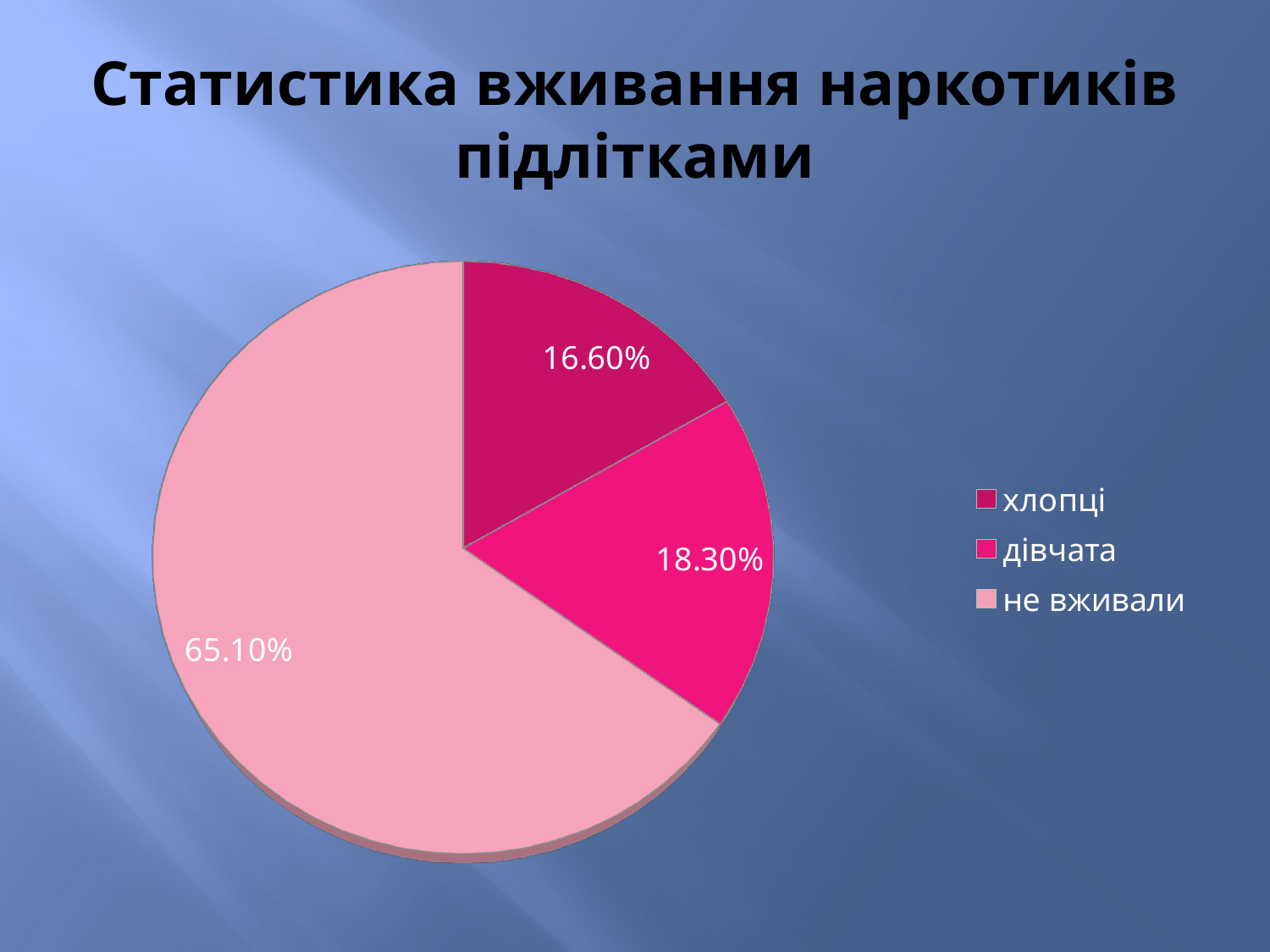
How many entries does the legend list? 3 What is the title of the slide? Статистика вживання наркотиків підлітками What percentage is shown for хлопці? 16.60% Which category has the smallest slice of the pie? хлопці What percentage is shown for дівчата? 18.30% What is the difference between the percentages for не вживали and дівчата? 46.80% Which category has the largest slice of the pie? не вживали What percentage is shown for не вживали? 65.10% How many slices does the pie chart have? 3 What kind of chart is shown on the slide? pie chart Which is larger, the slice for дівчата or the slice for хлопці? дівчата What is the difference between the percentages for дівчата and хлопці? 1.70%